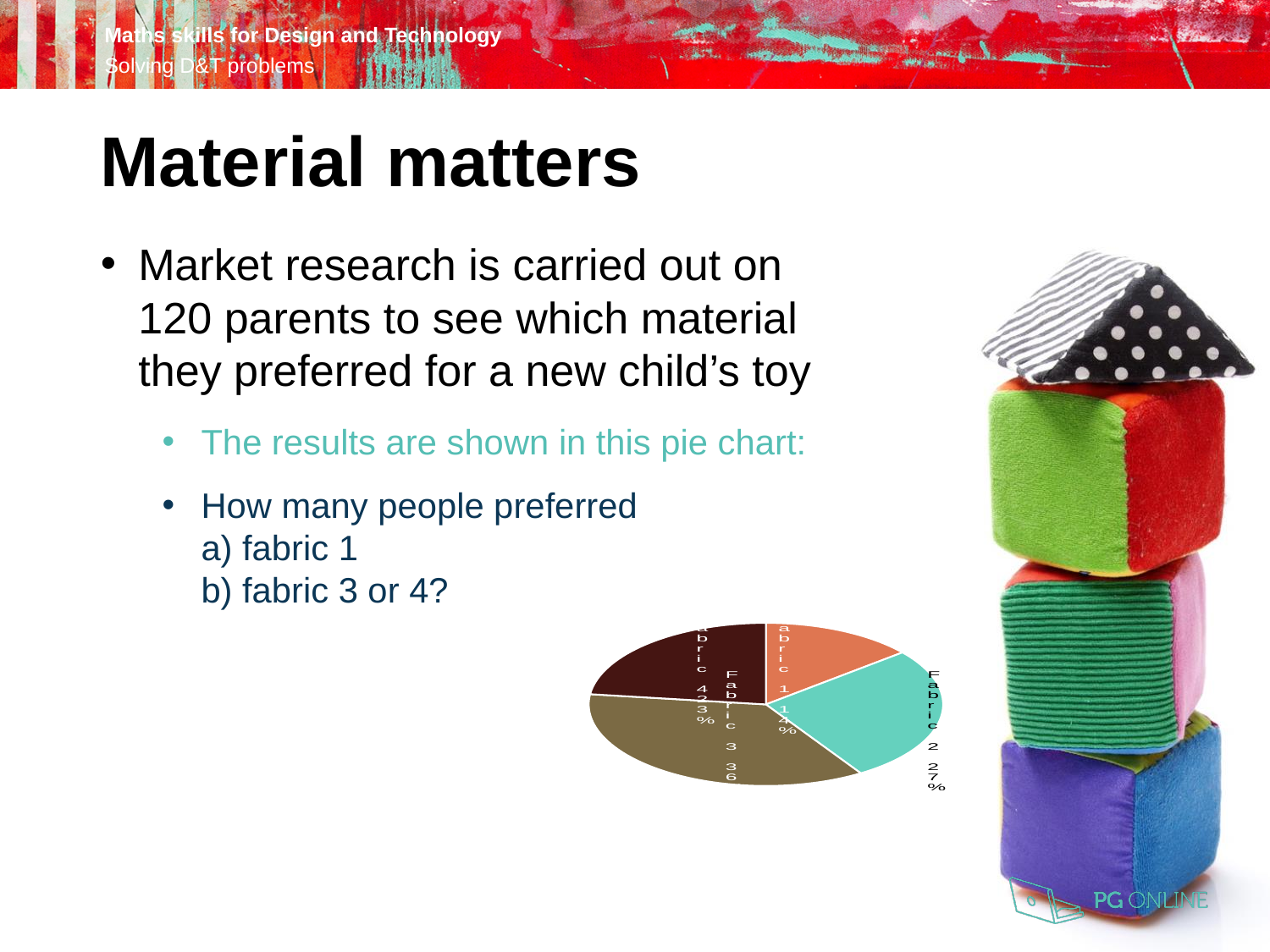
Which fabric has the smallest slice of the pie chart? Fabric 1 What percentage is shown for Fabric 2 in the pie chart? 27% How many slices does the pie chart have? 4 Which has the larger share in the pie chart, Fabric 2 or Fabric 4? Fabric 2 What percentage is shown for Fabric 4 in the pie chart? 23% What colour is the Fabric 1 slice in the pie chart? orange What percentage of parents preferred Fabric 1 according to the pie chart? 14% Which fabric has the largest slice of the pie chart? Fabric 3 What kind of chart is shown on the slide? pie chart By how many percentage points does Fabric 2's share exceed Fabric 1's share? 13 By how many percentage points does Fabric 4's share exceed Fabric 1's share? 9 What colour is the Fabric 2 slice in the pie chart? teal